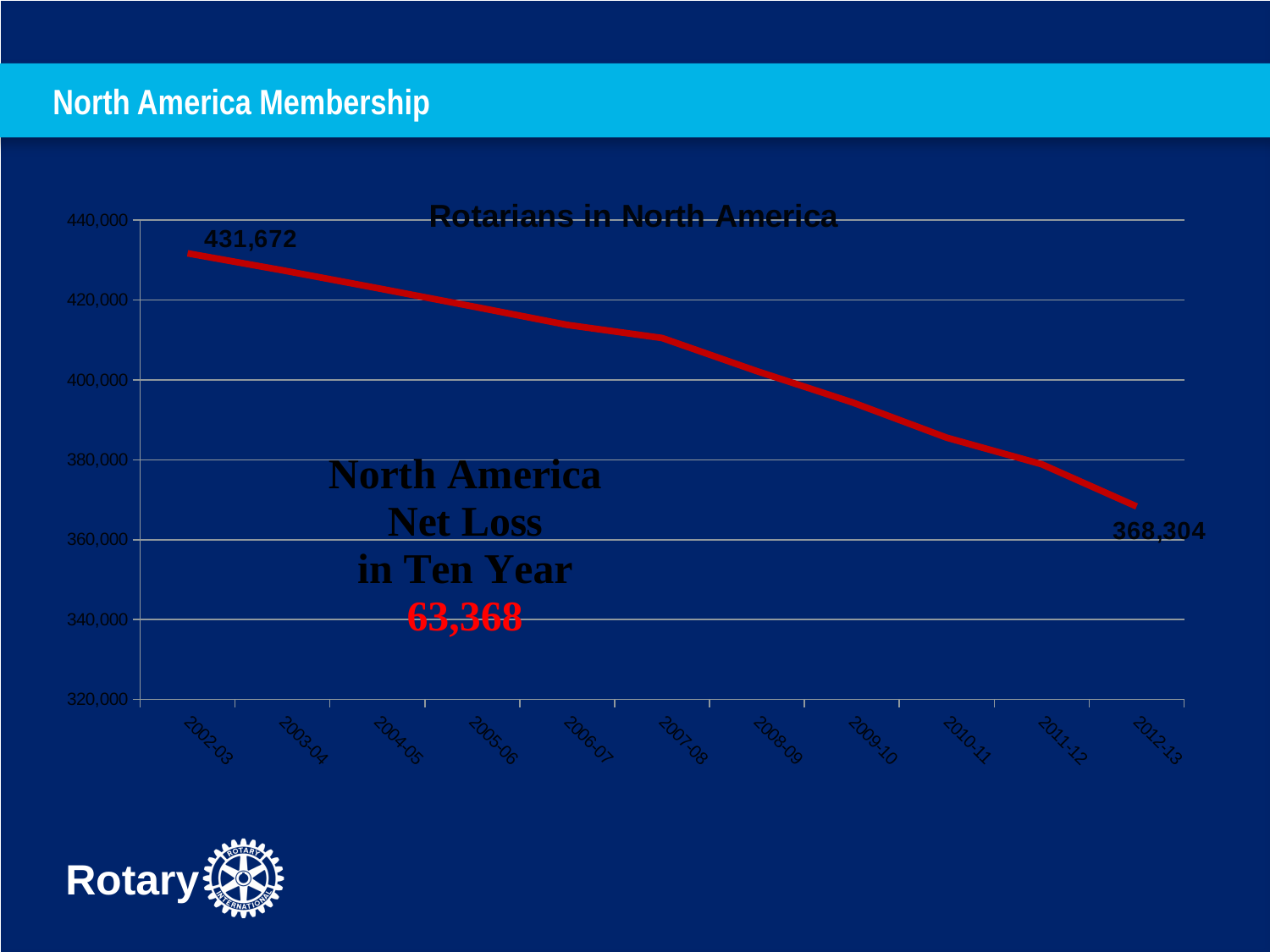
Which is larger, the value for 2002-03 or the value for 2012-13? 2002-03 Which year has the lowest value? 2012-13 What is the value for 2002-03? 431,672 What kind of chart is shown on the slide? line chart Do the values rise or fall from 2002-03 to 2012-13? fall Which year has the highest value? 2002-03 What is the difference between the values for 2002-03 and 2012-13? 63,368 Is the value for 2007-08 greater or less than 400,000? greater What is the title of the chart? Rotarians in North America How many years are plotted on the x axis? 11 What is the value for 2012-13? 368,304 Is the value for 2009-10 greater or less than 400,000? less